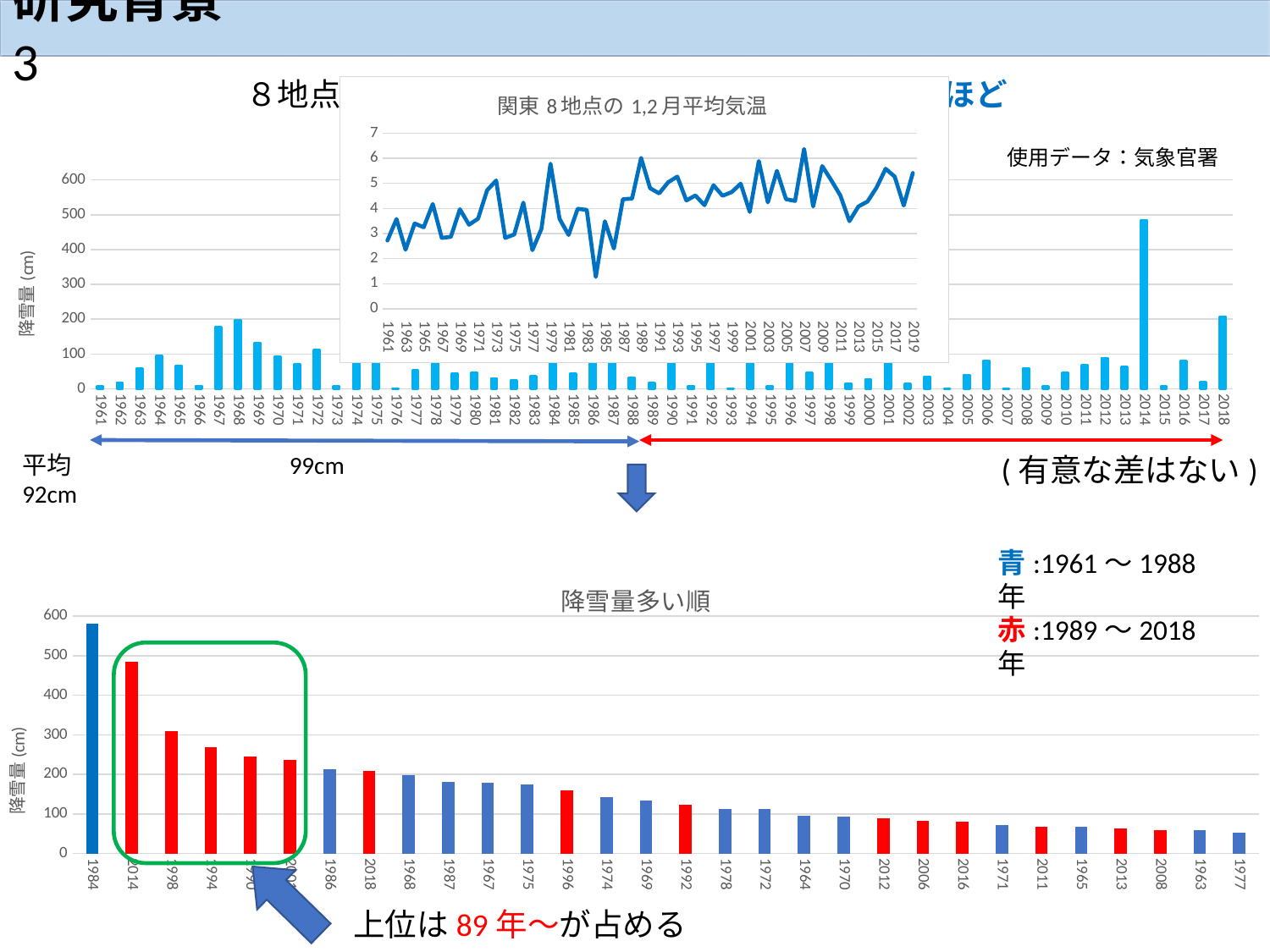
In the bottom chart 降雪量多い順, is the value for 2014 greater or less than 400? greater How many years (bars) are shown in the bottom chart 降雪量多い順? 30 What is the title of the inset line chart on the slide? 関東 8地点の 1,2月平均気温 In the bottom chart 降雪量多い順, which year has the highest snowfall? 1984 What kind of chart is the inset chart titled 関東 8地点の 1,2月平均気温? line chart In the bottom chart 降雪量多い順, which is larger, the value for 2014 or the value for 1998? 2014 In the bottom chart 降雪量多い順, which year has the lowest snowfall? 1977 In the top bar chart of snowfall by year, is the value for 2014 greater or less than 400? greater In the bottom chart 降雪量多い順, do the values rise or fall from left to right along the x axis? fall In the bottom chart 降雪量多い順, is the value for 1977 greater or less than 100? less What kind of chart is the bottom chart titled 降雪量多い順? bar chart